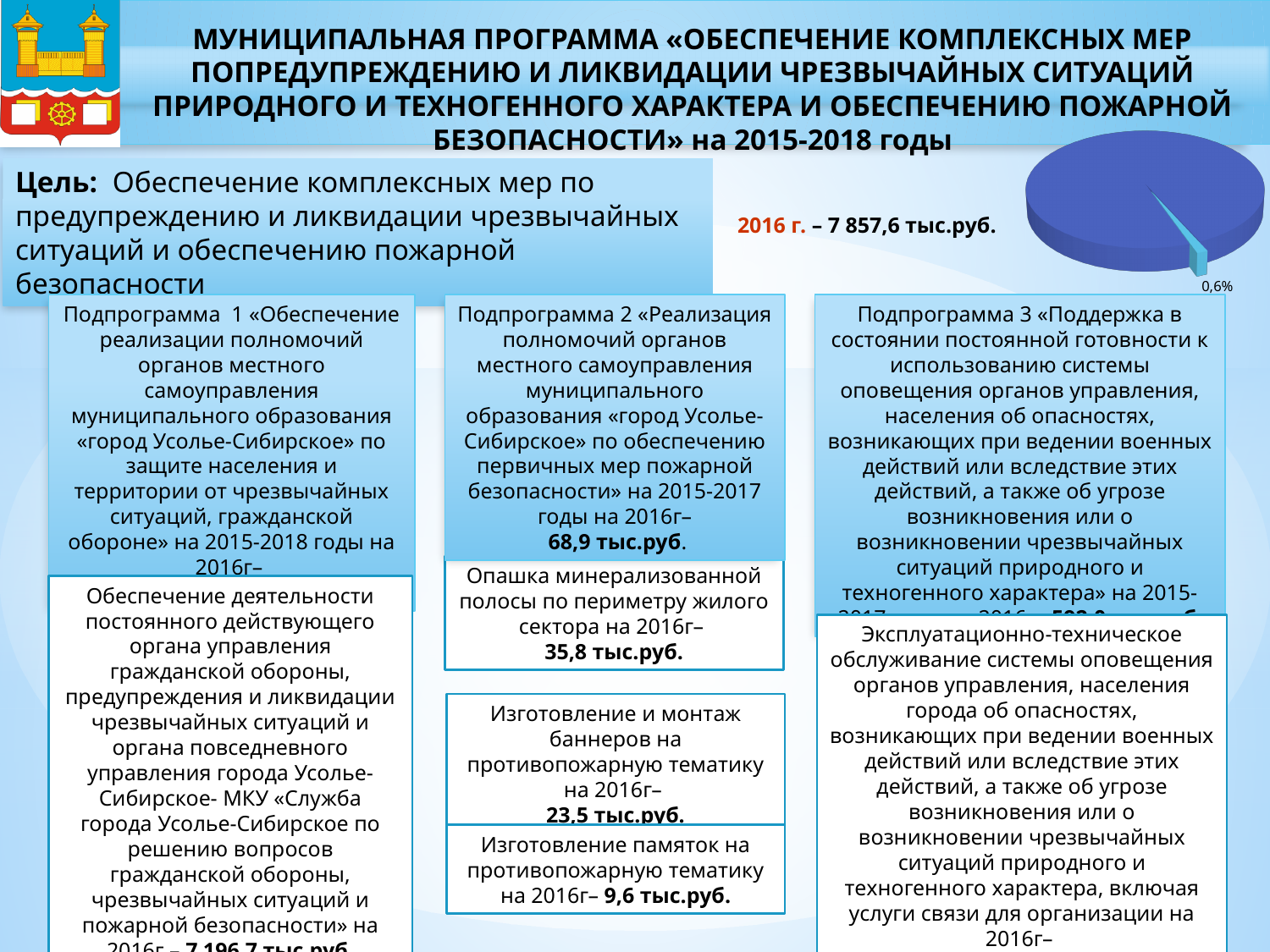
How many data labels are printed on the pie chart? 1 Is the pie chart drawn in 3D? yes What kind of chart is shown in the top right of the slide? pie chart What colour is the largest slice of the pie chart? blue Which slice of the pie chart is larger, the large blue slice or the slice labelled 0,6%? the large blue slice What percentage label is printed next to the small slice of the pie chart? 0,6%